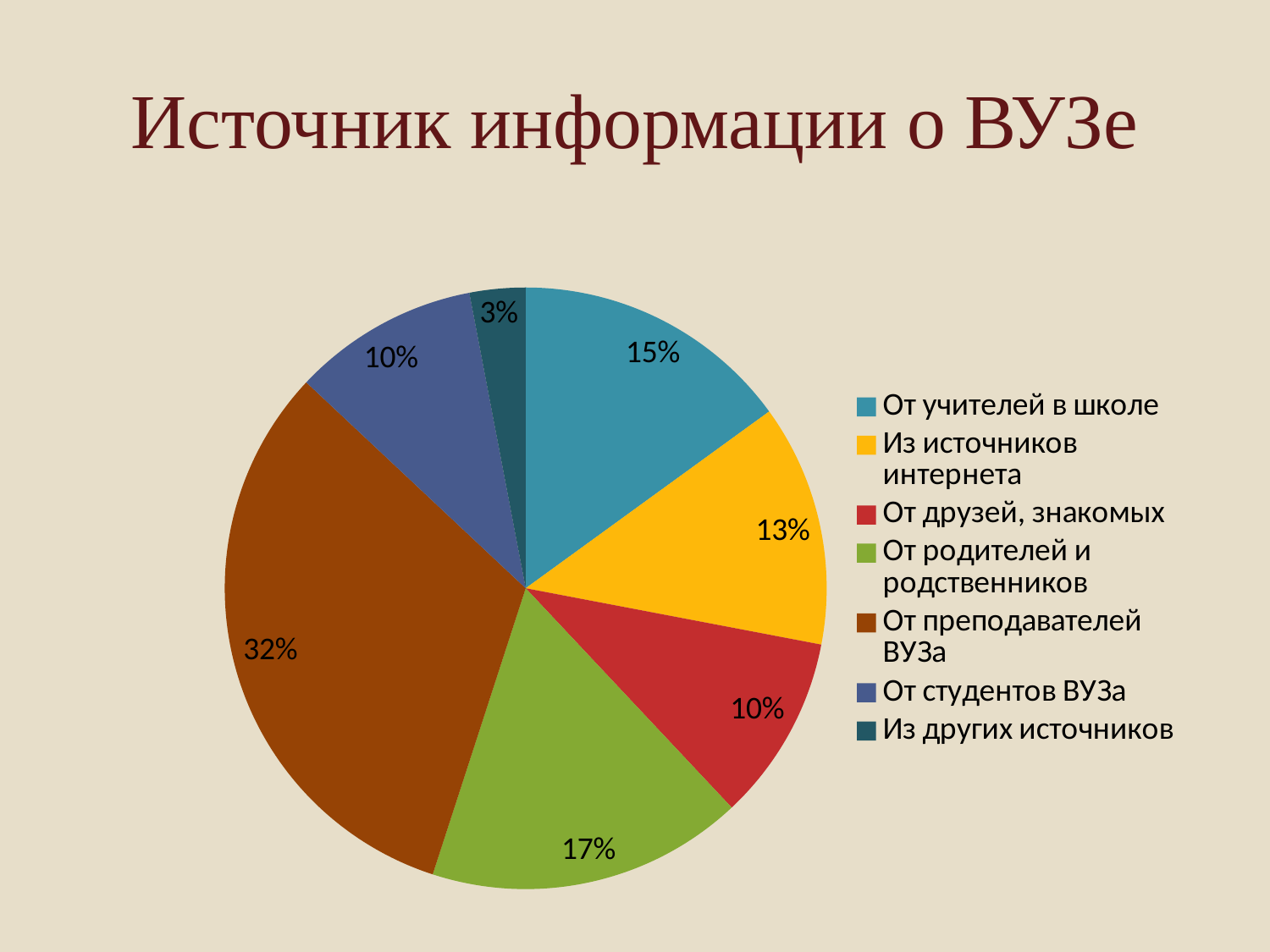
What is the value for 'От учителей в школе'? 15% Which is larger: the share for 'От учителей в школе' or for 'Из источников интернета'? От учителей в школе What is the value for 'От родителей и родственников'? 17% What is the title of the chart? Источник информации о ВУЗе What share of the pie is 'От преподавателей ВУЗа'? 32% Which category has the largest share of the pie? От преподавателей ВУЗа Which category has the smallest share of the pie? Из других источников What is the value for 'Из других источников'? 3% What is the value for 'Из источников интернета'? 13% What is the difference between the shares for 'От преподавателей ВУЗа' and 'От родителей и родственников'? 15% How many categories does the legend list? 7 What type of chart is shown on the slide? pie chart